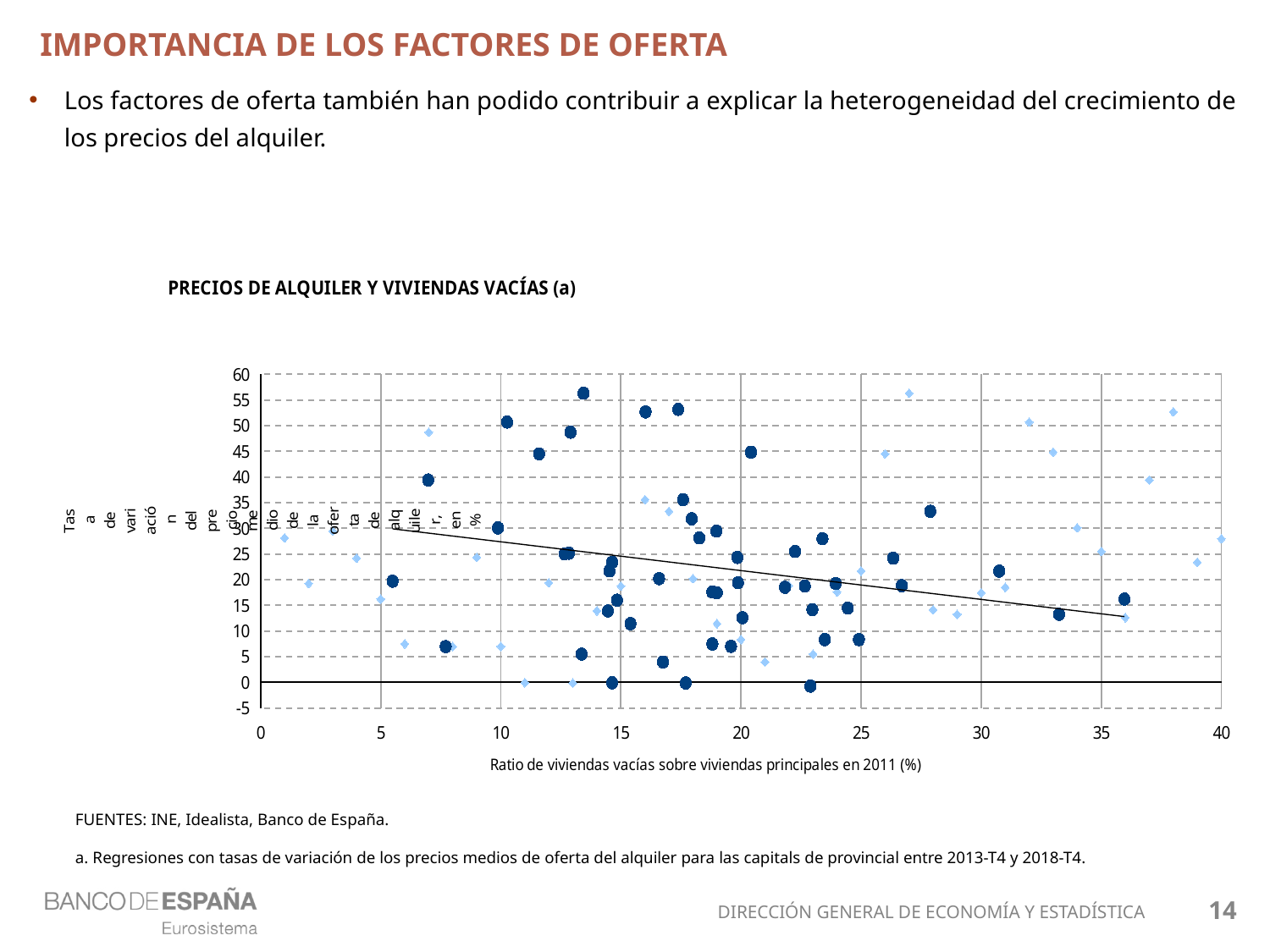
What is the highest value shown on the vertical axis of the chart? 60 What is the label of the horizontal axis of the chart? Ratio de viviendas vacías sobre viviendas principales en 2011 (%) Is the value of the trend line at a ratio of 0 greater or less than 25? greater What is the title of the chart on the slide? PRECIOS DE ALQUILER Y VIVIENDAS VACÍAS (a) What is the highest value shown on the horizontal axis of the chart? 40 Is the value of the trend line at a ratio of 35 greater or less than 20? less What is the lowest value shown on the vertical axis of the chart? -5 Does the fitted trend line in the chart rise or fall as the ratio of empty dwellings increases along the x axis? Fall What kind of chart is shown on the slide? Scatter chart